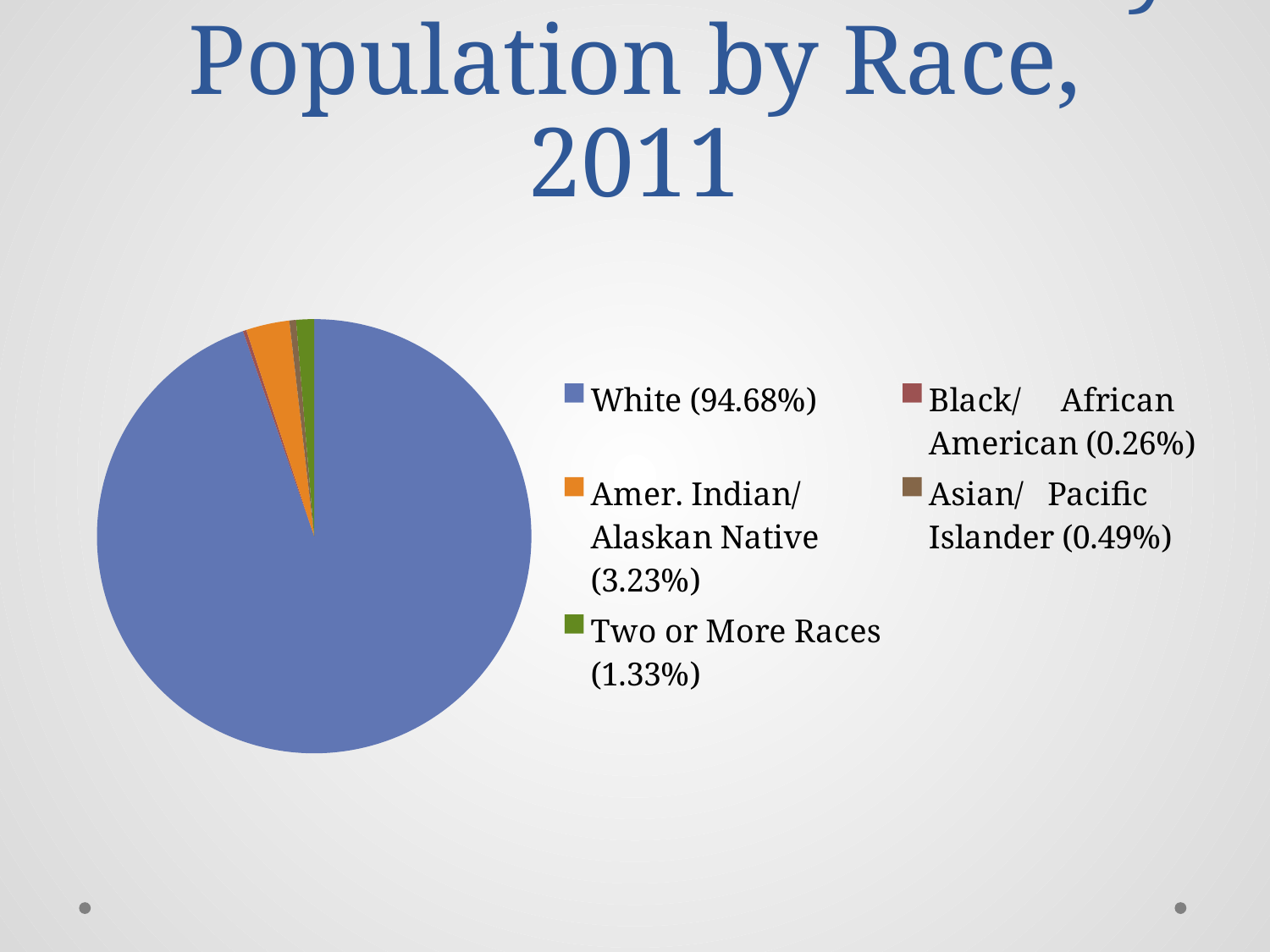
What percentage is shown for Two or More Races? 1.33% How many categories does the pie chart show? 5 Which is larger, the share for Asian/Pacific Islander or the share for Black/African American? Asian/Pacific Islander What percentage is shown for Asian/Pacific Islander? 0.49% What is the difference in percentage points between Amer. Indian/Alaskan Native and Two or More Races? 1.90% Which category has the largest share of the pie? White What kind of chart is shown on the slide? Pie chart What percentage is shown for Black/African American? 0.26% Which category has the smallest share of the pie? Black/African American What colour is the slice for Amer. Indian/Alaskan Native? Orange What percentage of the population is White according to the chart? 94.68% What percentage is shown for Amer. Indian/Alaskan Native? 3.23%